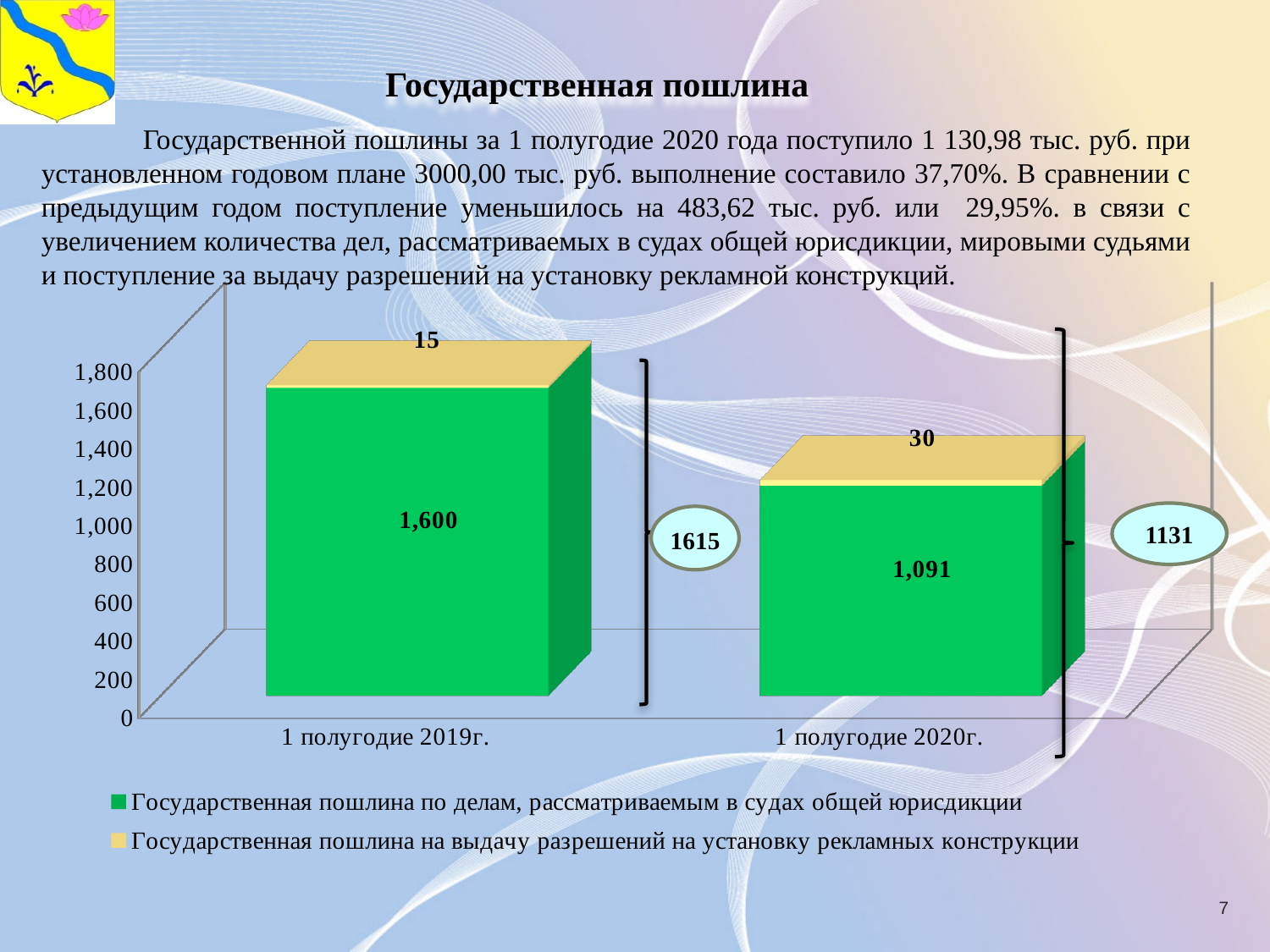
Is the yellow series value larger in 1 полугодие 2019г. or in 1 полугодие 2020г.? 1 полугодие 2020г. How many series does the legend list? 2 What is the value of the yellow series (Государственная пошлина на выдачу разрешений на установку рекламных конструкции) for 1 полугодие 2020г.? 30 How many periods (categories) are shown on the x axis? 2 What kind of chart is shown on the slide? Stacked bar chart Which period has the lower value for the yellow series (advertising permit fees)? 1 полугодие 2019г. What is the value of the green series (Государственная пошлина по делам, рассматриваемым в судах общей юрисдикции) for 1 полугодие 2019г.? 1,600 What is the value of the green series (Государственная пошлина по делам, рассматриваемым в судах общей юрисдикции) for 1 полугодие 2020г.? 1,091 Which period has the higher value for the green series (court fees)? 1 полугодие 2019г. What total is shown in the oval next to the 1 полугодие 2019г. bar? 1615 What is the difference between the green series values for 1 полугодие 2019г. and 1 полугодие 2020г.? 509 What is the value of the yellow series (Государственная пошлина на выдачу разрешений на установку рекламных конструкции) for 1 полугодие 2019г.? 15